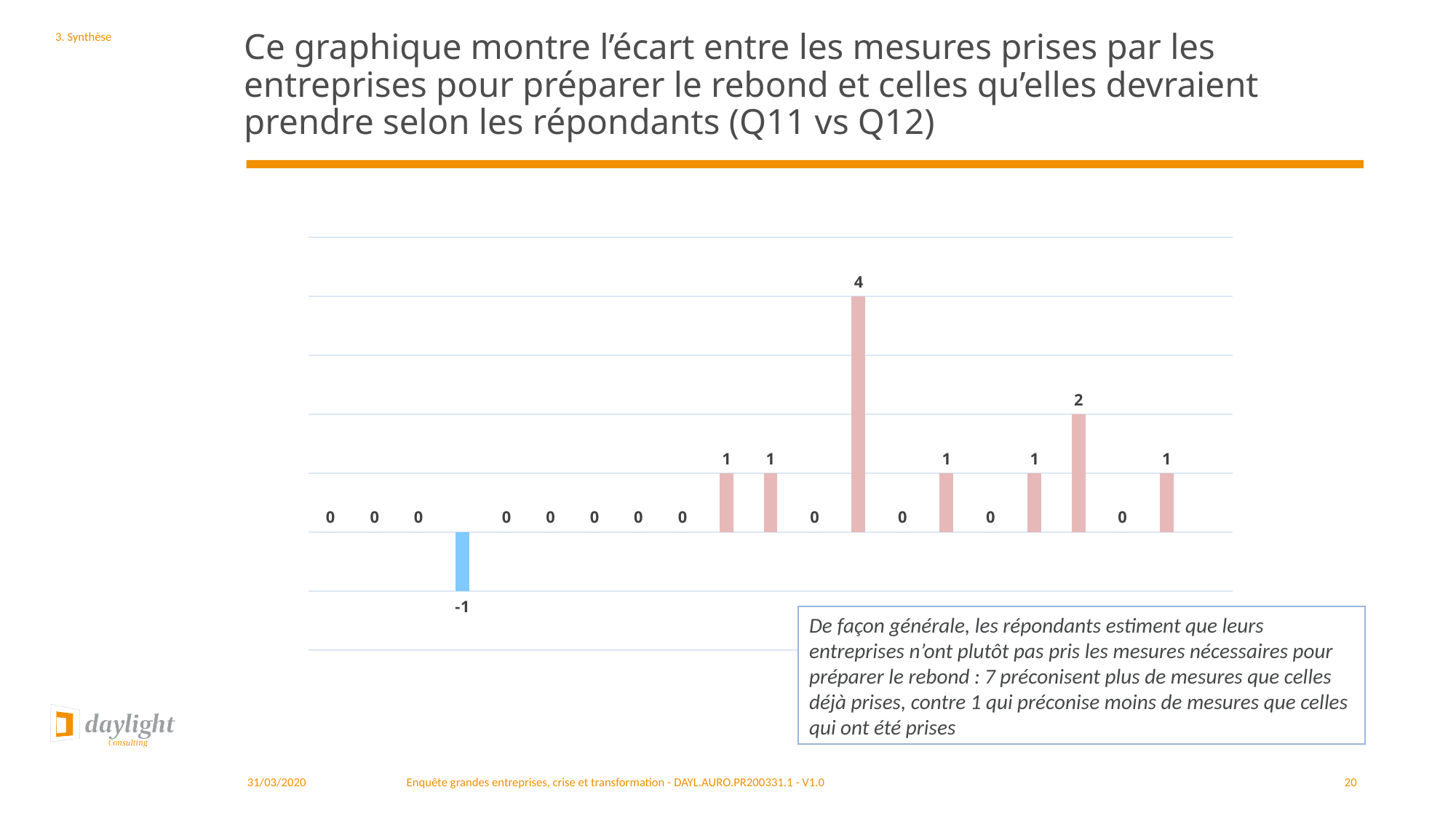
How many bars in the chart have a value of 0? 12 How many bars (data points) are plotted in the chart? 20 How many bars in the chart have a positive value? 7 What is the lowest value shown in the chart? -1 What is the difference between the highest and the lowest value in the chart? 5 What colour is the bar with the negative value? blue What is the value of the blue bar in the chart? -1 What is the highest value shown in the chart? 4 What kind of chart is shown on the slide? bar chart What is the value of the second-highest bar in the chart? 2